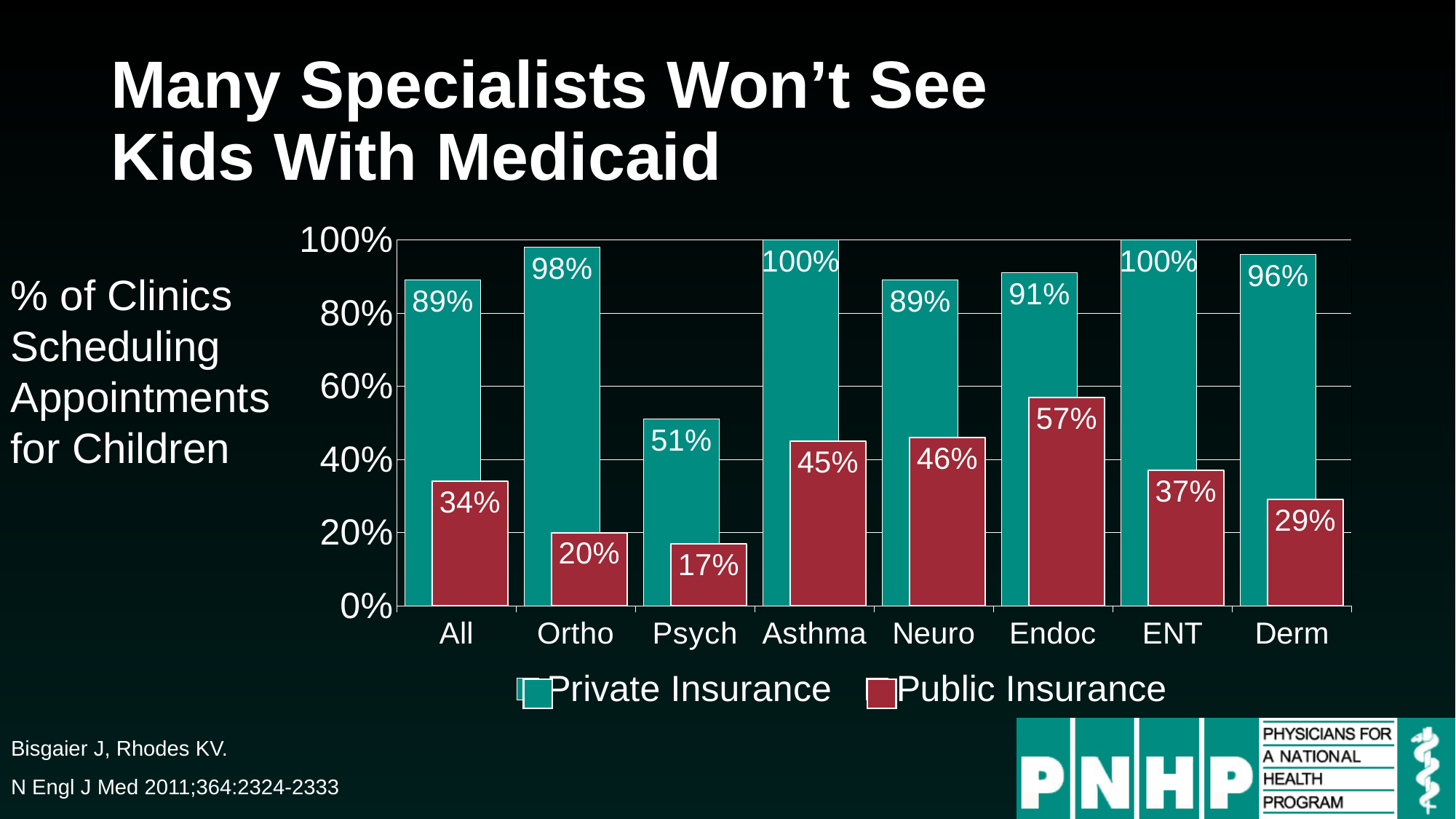
What is the Private Insurance value for Ortho? 98% How many categories are shown on the x axis? 8 What is the Public Insurance value for Psych? 17% Which is larger, the Public Insurance value for Asthma or for ENT? Asthma Which series is shown in red? Public Insurance What is the difference between the Private Insurance and Public Insurance values for Derm? 67% What kind of chart is shown on the slide? bar chart How many series does the legend list? 2 Which category has the lowest Private Insurance value? Psych Is the Public Insurance value for Neuro greater or less than 40%? greater Which category has the highest Public Insurance value? Endoc What is the Public Insurance value for Endoc? 57%